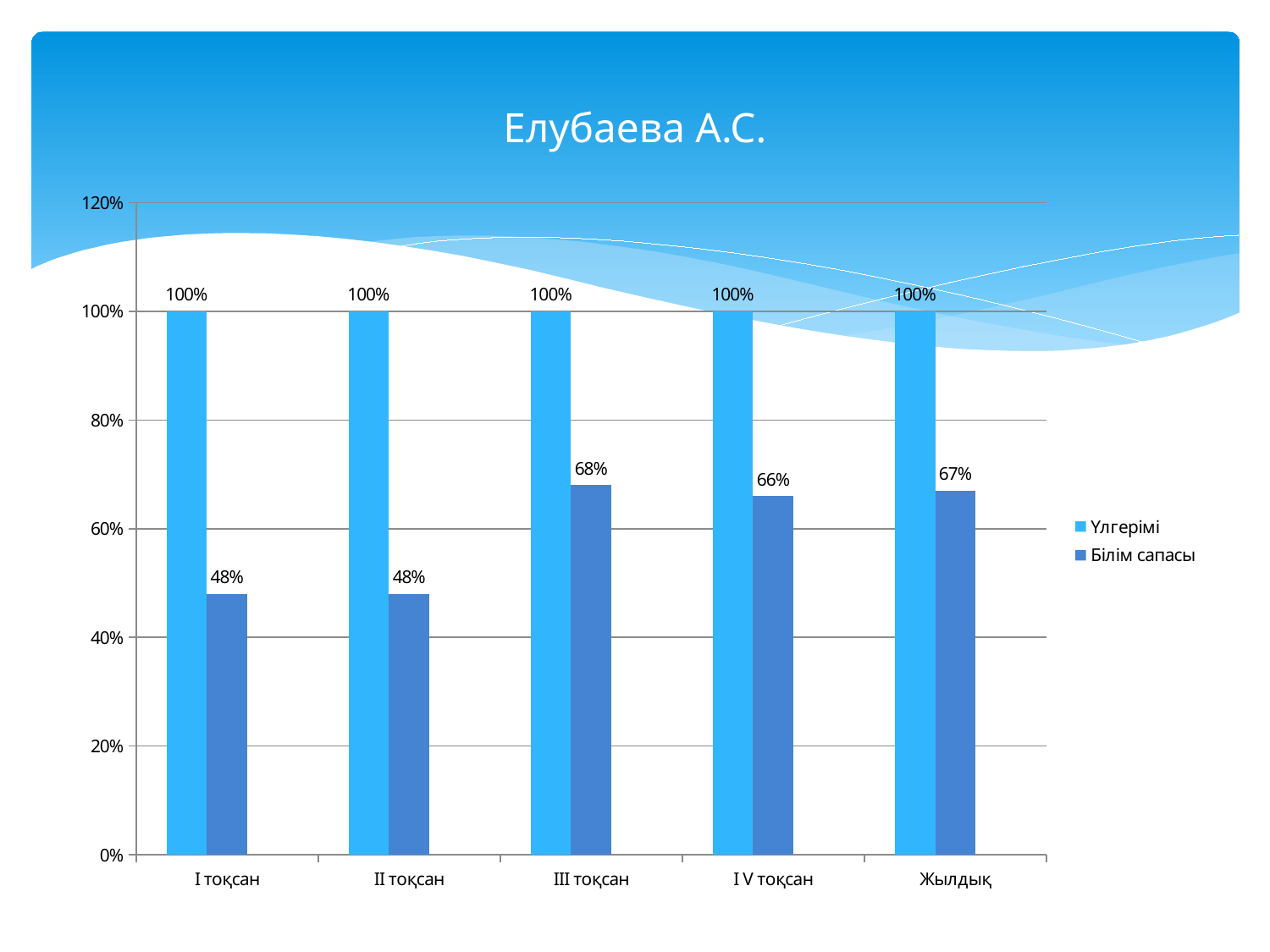
Which is larger, Білім сапасы for III тоқсан or for I V тоқсан? III тоқсан Which category has the highest Білім сапасы value? III тоқсан What kind of chart is shown on the slide? Bar chart What is the difference between Үлгерімі and Білім сапасы for I V тоқсан? 34% What is the title of the chart? Елубаева А.С. What is the value of Білім сапасы for III тоқсан? 68% What is the value of Үлгерімі for I тоқсан? 100% How many categories are shown on the x axis? 5 Which categories have the lowest Білім сапасы value? I тоқсан and II тоқсан What is the value of Білім сапасы for Жылдық? 67% How many series does the legend list? 2 What is the difference in Білім сапасы between III тоқсан and II тоқсан? 20%